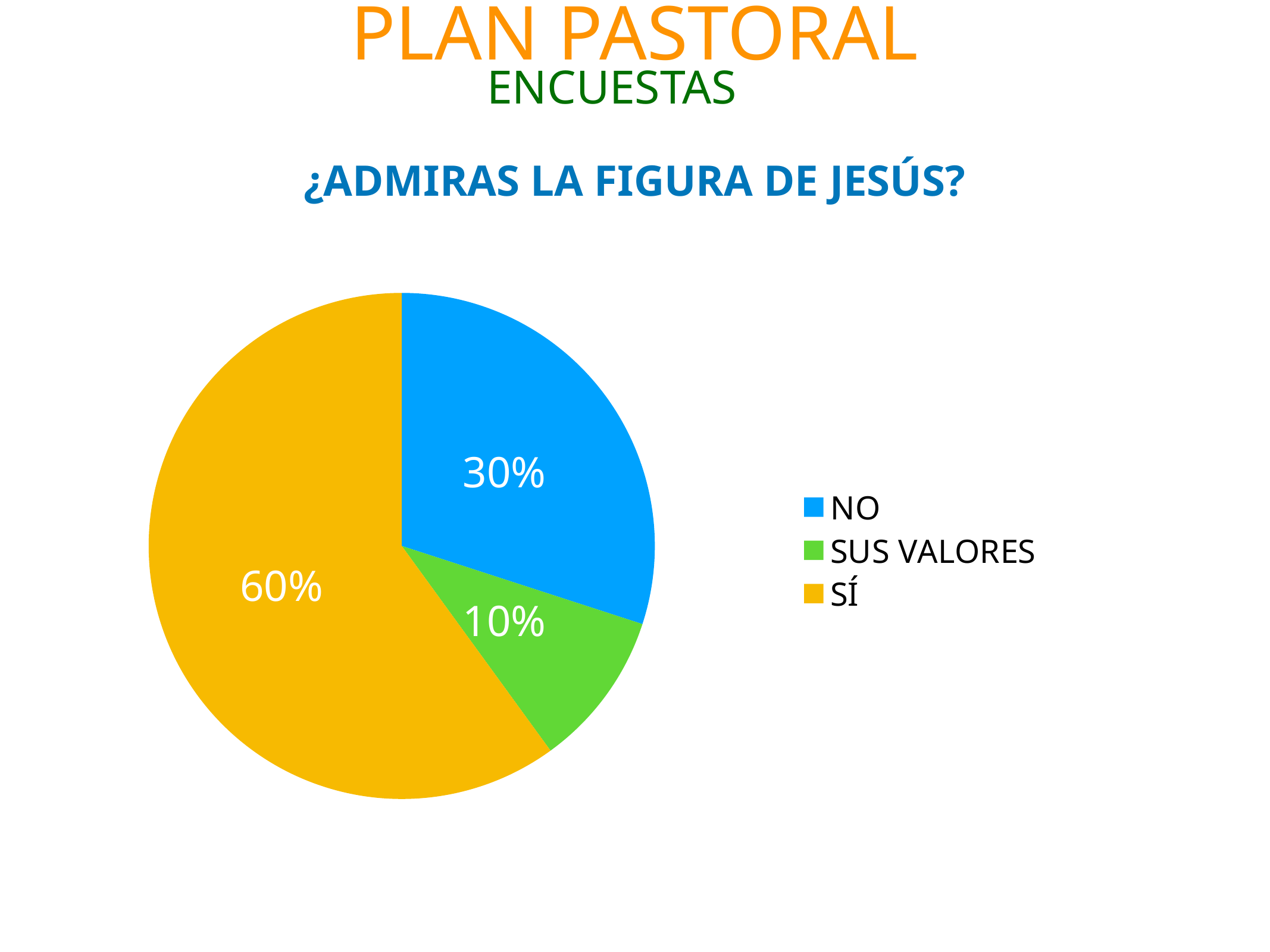
What percentage of the pie is labelled SÍ? 60% How many entries does the legend list? 3 Which category has the largest slice of the pie? SÍ How many slices does the pie chart have? 3 What is the difference in percentage points between the NO slice and the SUS VALORES slice? 20 What is the difference in percentage points between the SÍ slice and the NO slice? 30 What percentage of the pie is labelled SUS VALORES? 10% What is the title of the chart? ¿ADMIRAS LA FIGURA DE JESÚS? What percentage of the pie is labelled NO? 30% Which slice is larger, NO or SUS VALORES? NO What kind of chart is shown on the slide? Pie chart Which category has the smallest slice of the pie? SUS VALORES